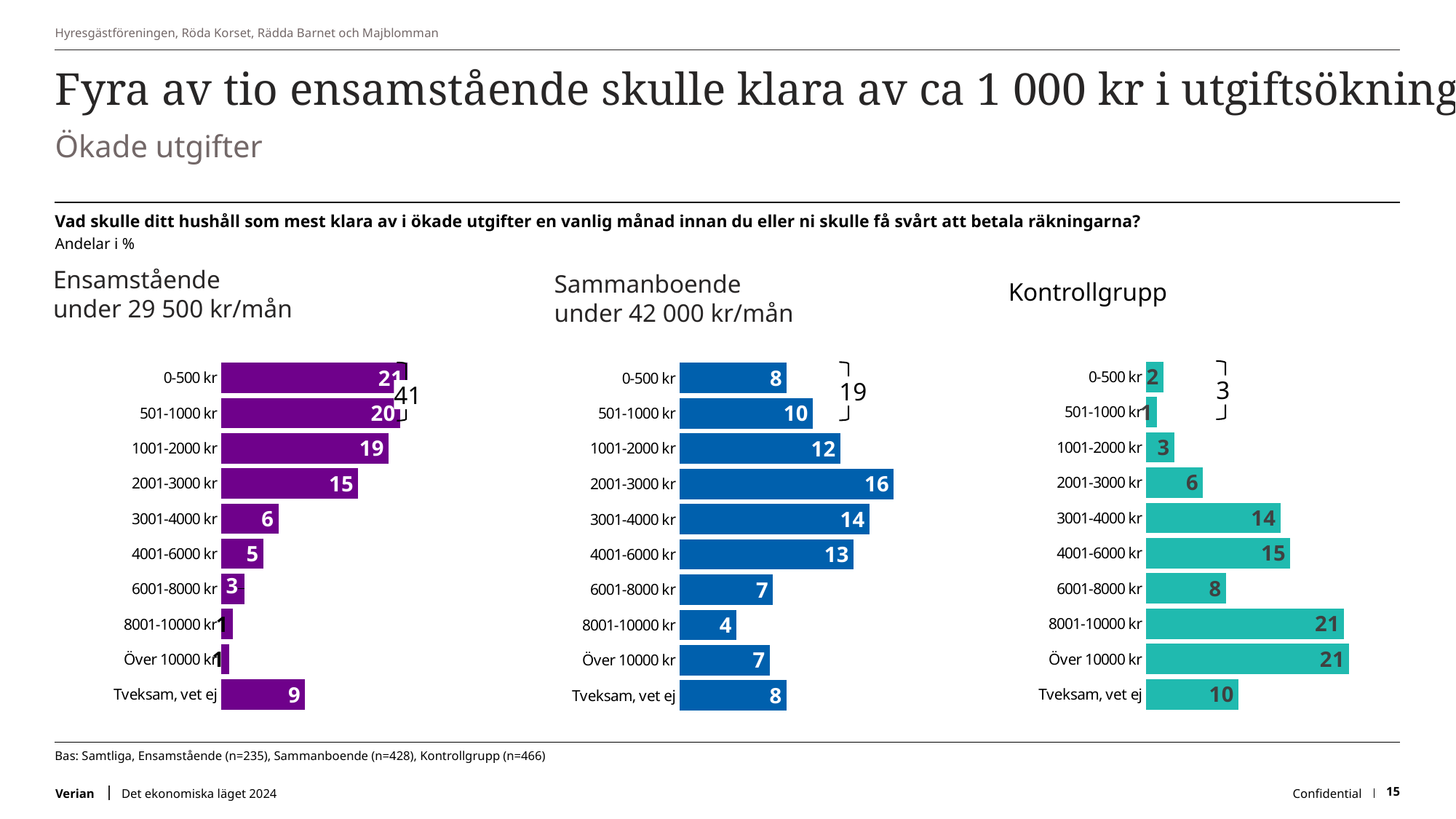
In the Kontrollgrupp chart, which category has the lowest value? 501-1000 kr In the Sammanboende under 42 000 kr/mån chart, what combined value is shown by the bracket for 0-500 kr and 501-1000 kr? 19 In the Ensamstående under 29 500 kr/mån chart, what combined value is shown by the bracket for 0-500 kr and 501-1000 kr? 41 In the Sammanboende under 42 000 kr/mån chart, which category has the highest value? 2001-3000 kr What kind of chart is the Kontrollgrupp chart? Bar chart In the Kontrollgrupp chart, which is larger: the value for 3001-4000 kr or the value for 6001-8000 kr? 3001-4000 kr In the Kontrollgrupp chart, what is the value for Tveksam, vet ej? 10 In the Ensamstående under 29 500 kr/mån chart, what is the difference between the values for 1001-2000 kr and 3001-4000 kr? 13 How many charts are shown on the slide? 3 How many categories does the Sammanboende under 42 000 kr/mån chart show? 10 In the Sammanboende under 42 000 kr/mån chart, what is the value for 4001-6000 kr? 13 In the Ensamstående under 29 500 kr/mån chart, what is the value for 2001-3000 kr? 15